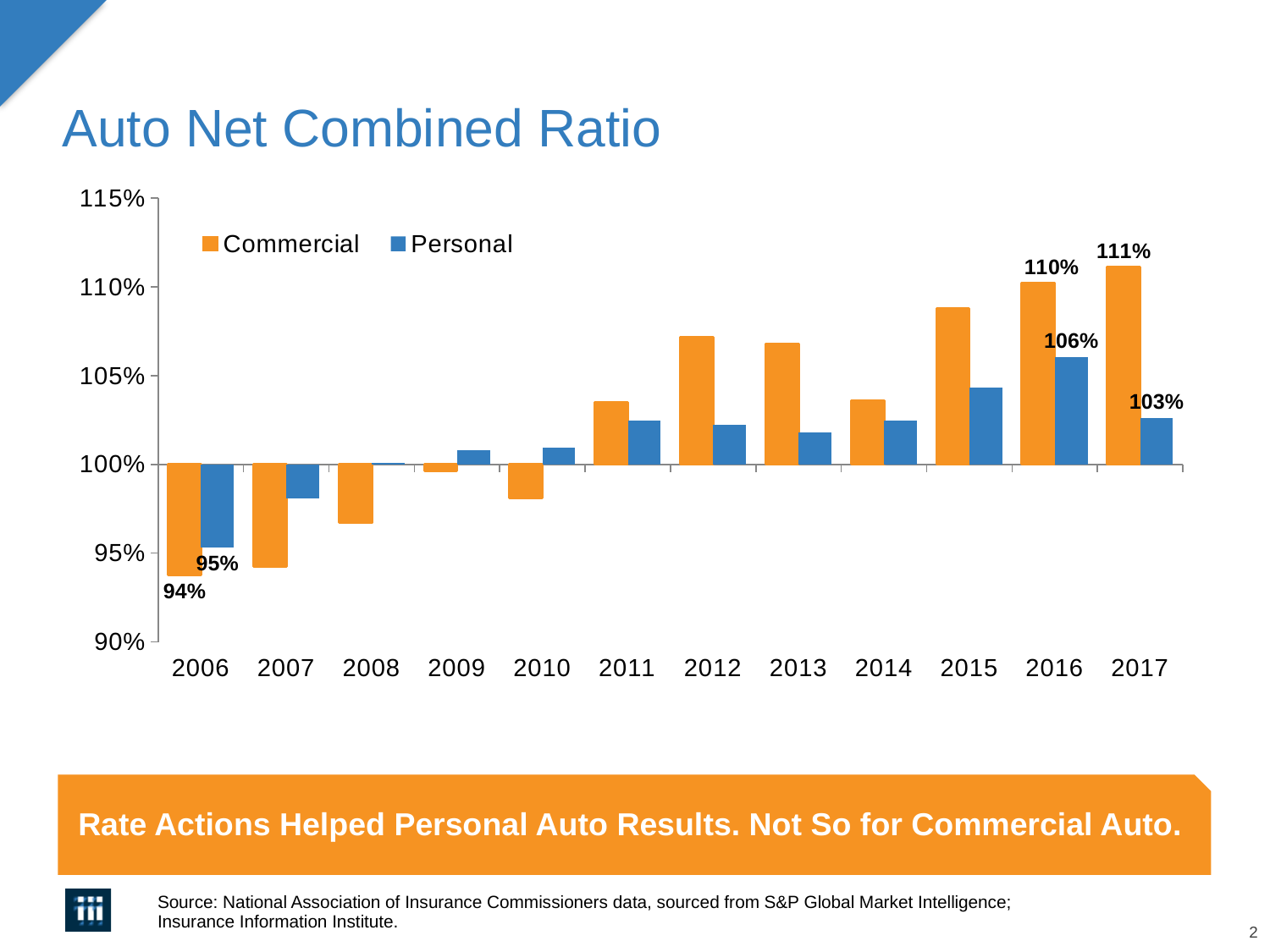
What is the Personal auto net combined ratio for 2016? 106% How many years are shown on the x axis of the chart? 12 How many series does the chart's legend list? 2 Is the Personal combined ratio for 2010 greater or less than 105%? less Is the Commercial combined ratio for 2012 greater or less than 105%? greater In 2016, which series has the higher combined ratio, Commercial or Personal? Commercial Which year has the highest Personal combined ratio? 2016 Which year has the highest Commercial combined ratio? 2017 In 2017, how many percentage points higher is the Commercial combined ratio than the Personal combined ratio? 8 percentage points What is the Personal auto net combined ratio for 2017? 103% What is the Commercial auto net combined ratio for 2017? 111% What is the Commercial auto net combined ratio for 2006? 94%